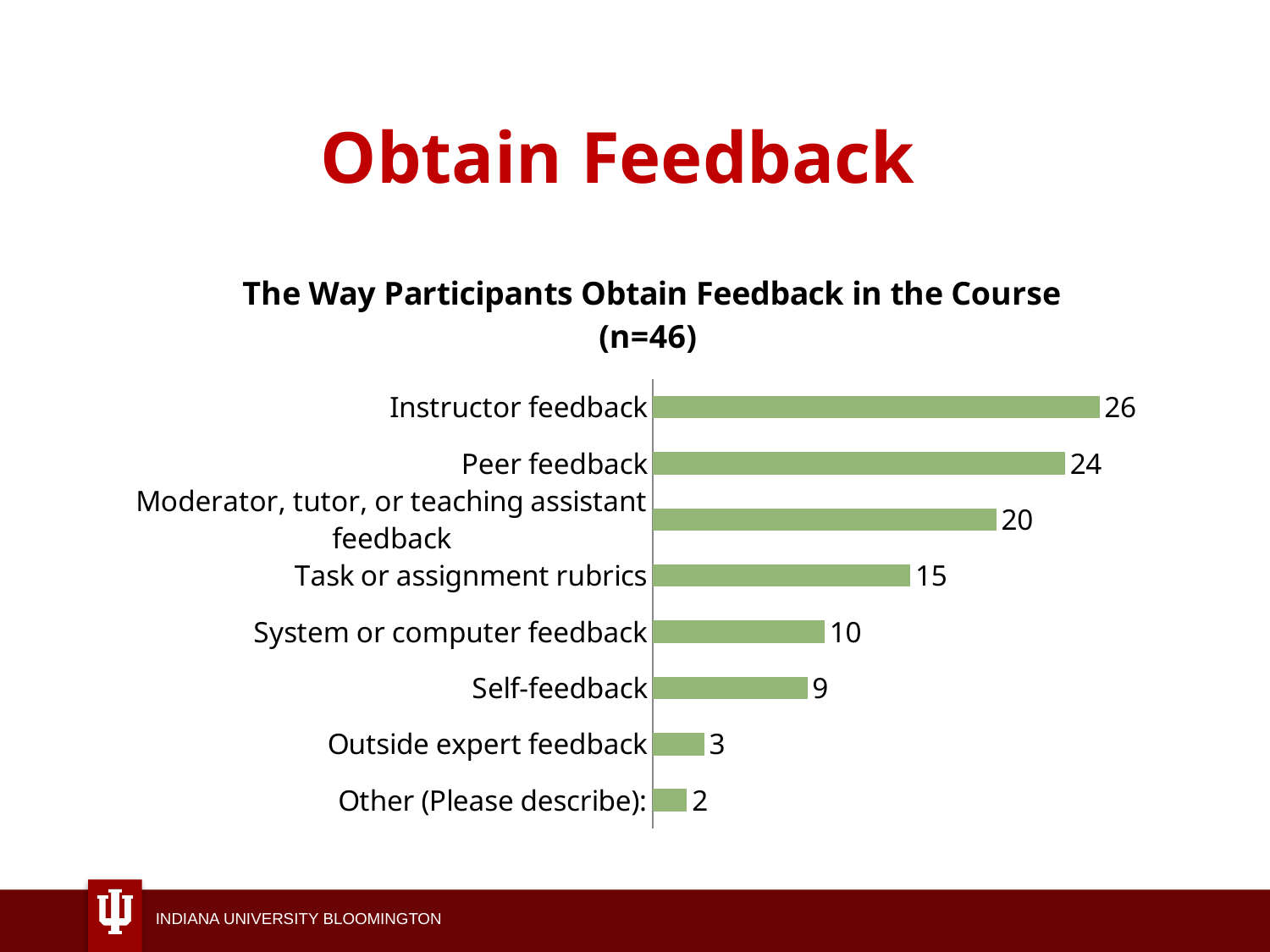
What is the value for Self-feedback? 9 What is the value for Task or assignment rubrics? 15 How many categories are shown in the chart? 8 What is the value for Instructor feedback? 26 Which category has the highest value? Instructor feedback What is the difference between System or computer feedback and Outside expert feedback? 7 Which category has the lowest value? Other (Please describe): What kind of chart is this? Bar chart What is the sample size (n) stated in the chart title? 46 What is the title of the chart? The Way Participants Obtain Feedback in the Course (n=46) Which is larger, Peer feedback or Task or assignment rubrics? Peer feedback What is the difference between Peer feedback and Moderator, tutor, or teaching assistant feedback? 4